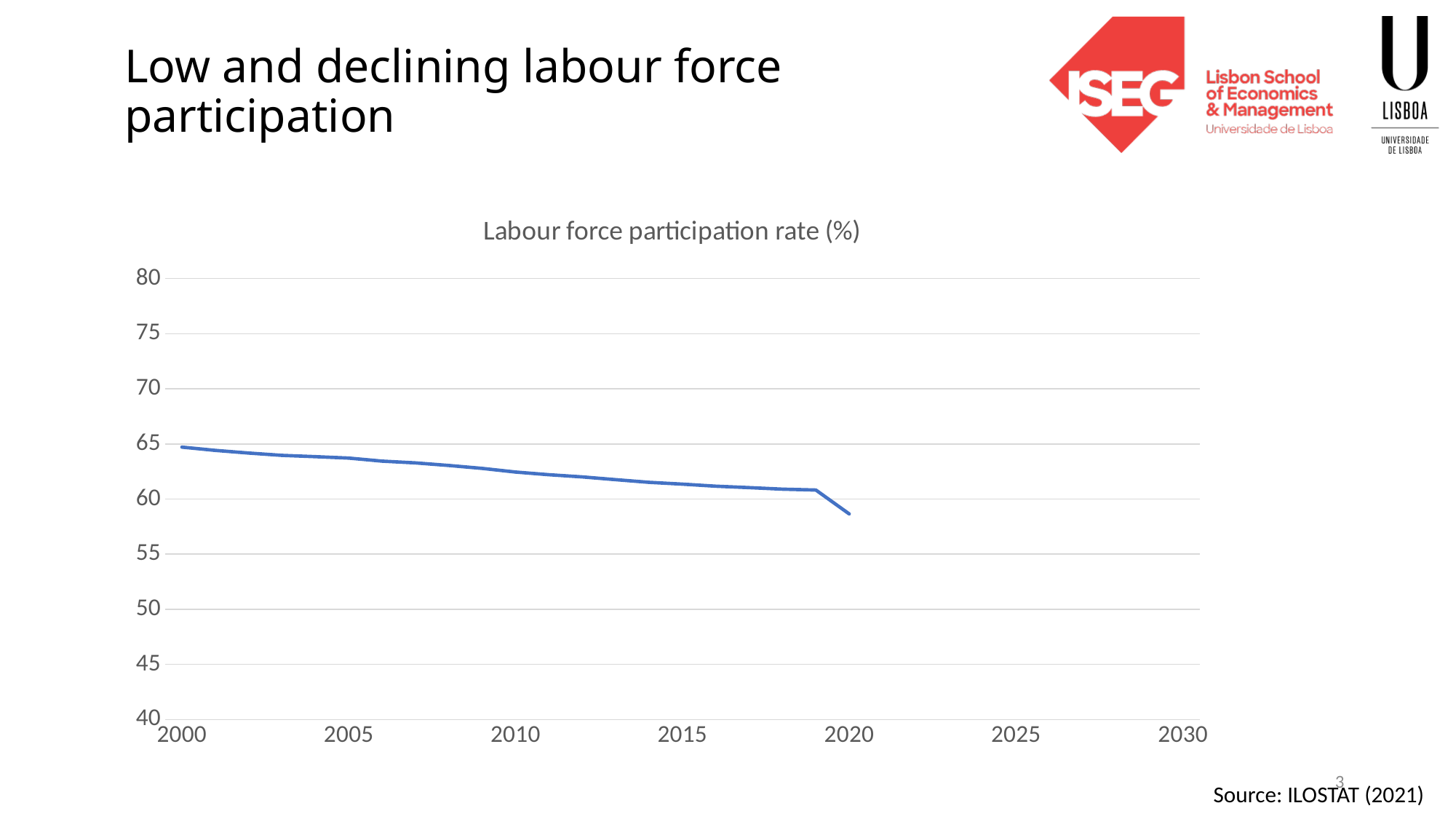
Is the labour force participation rate in 2010 greater or less than 65? less What is the title of the chart? Labour force participation rate (%) What kind of chart is shown on the slide? line chart Is the labour force participation rate in 2020 greater or less than 60? less Is the labour force participation rate in 2015 greater or less than 60? greater Which year shown has the highest labour force participation rate? 2000 Which year has a higher labour force participation rate, 2000 or 2020? 2000 Does the labour force participation rate rise or fall between 2000 and 2020? fall Which year shown has the lowest labour force participation rate? 2020